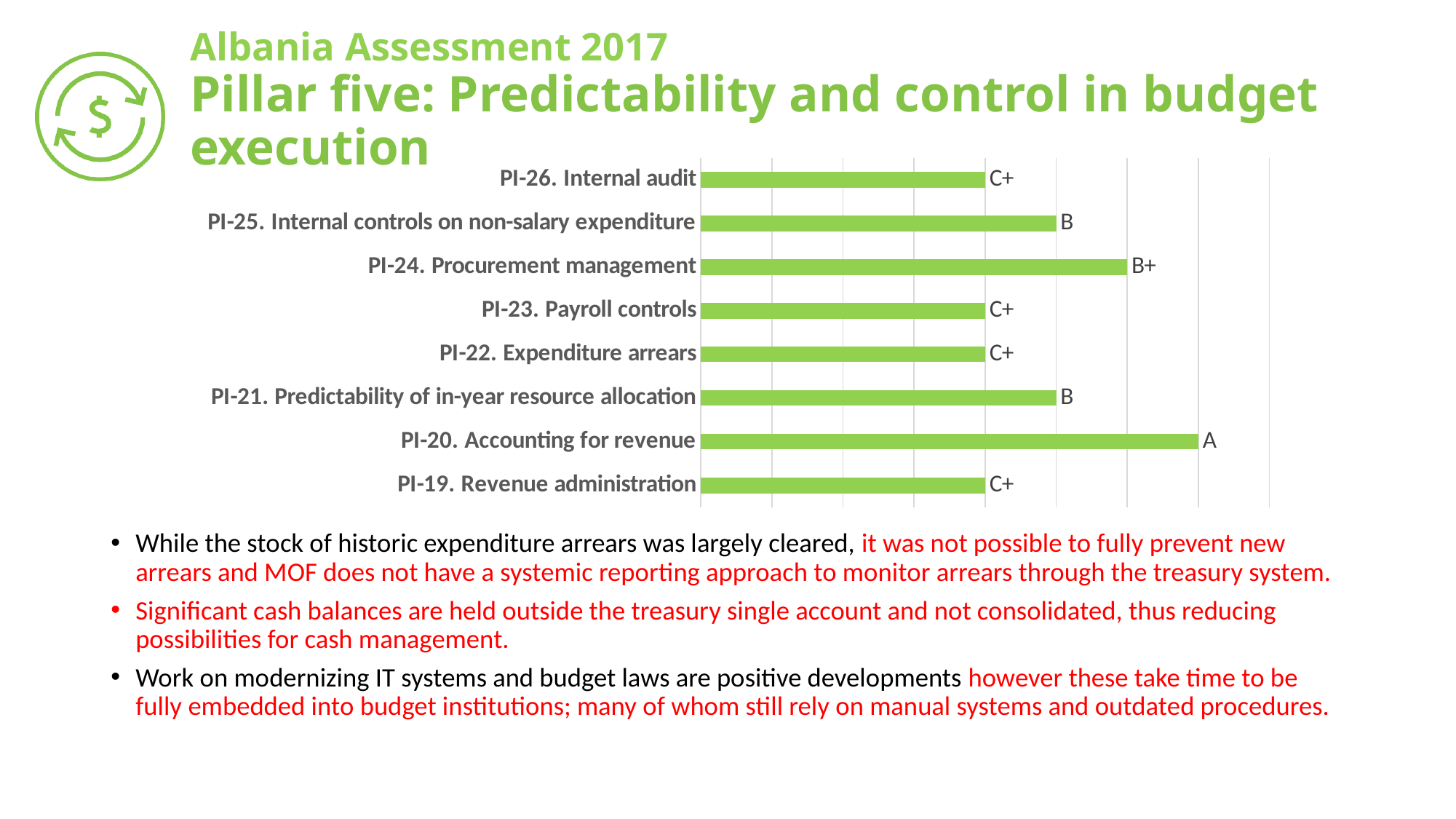
Which has the higher grade: PI-20. Accounting for revenue or PI-26. Internal audit? PI-20. Accounting for revenue Which has the higher grade: PI-24. Procurement management or PI-25. Internal controls on non-salary expenditure? PI-24. Procurement management What grade is shown for PI-21. Predictability of in-year resource allocation? B What type of chart is shown on the slide? Bar chart What grade is shown for PI-19. Revenue administration? C+ Which indicator has the highest grade (longest bar) in the chart? PI-20. Accounting for revenue What grade is shown for PI-24. Procurement management? B+ How many indicators in the chart received a grade of C+? 4 What grade is shown for PI-20. Accounting for revenue? A How many indicators (bars) are shown in the chart? 8 What colour are the bars in the chart? Green What grade is shown for PI-25. Internal controls on non-salary expenditure? B